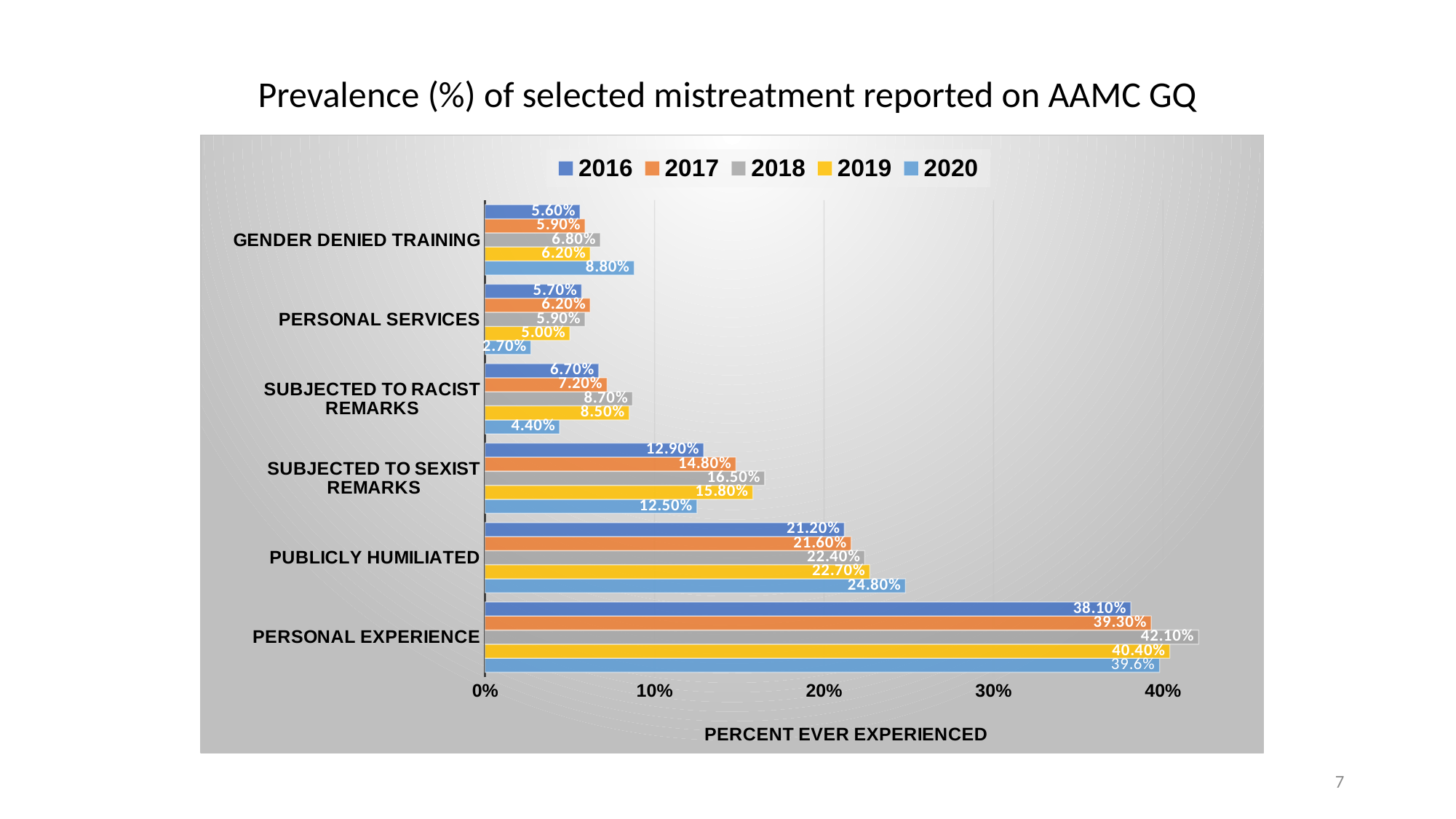
Which year has the highest value for Publicly Humiliated? 2020 Which is larger for Subjected to Sexist Remarks, the 2016 value or the 2017 value? 2017 How many series does the legend list? 5 Is the 2020 value for Personal Experience greater or less than 30%? greater What is the label of the horizontal axis? PERCENT EVER EXPERIENCED How many mistreatment categories are shown on the chart? 6 What is the 2020 value for Gender Denied Training? 8.80% What is the 2018 value for Personal Experience? 42.10% What is the difference between the 2018 and 2020 values for Subjected to Racist Remarks? 4.30% What type of chart is shown on the slide? Bar chart Which year has the lowest value for Personal Services? 2020 What is the 2019 value for Subjected to Sexist Remarks? 15.80%